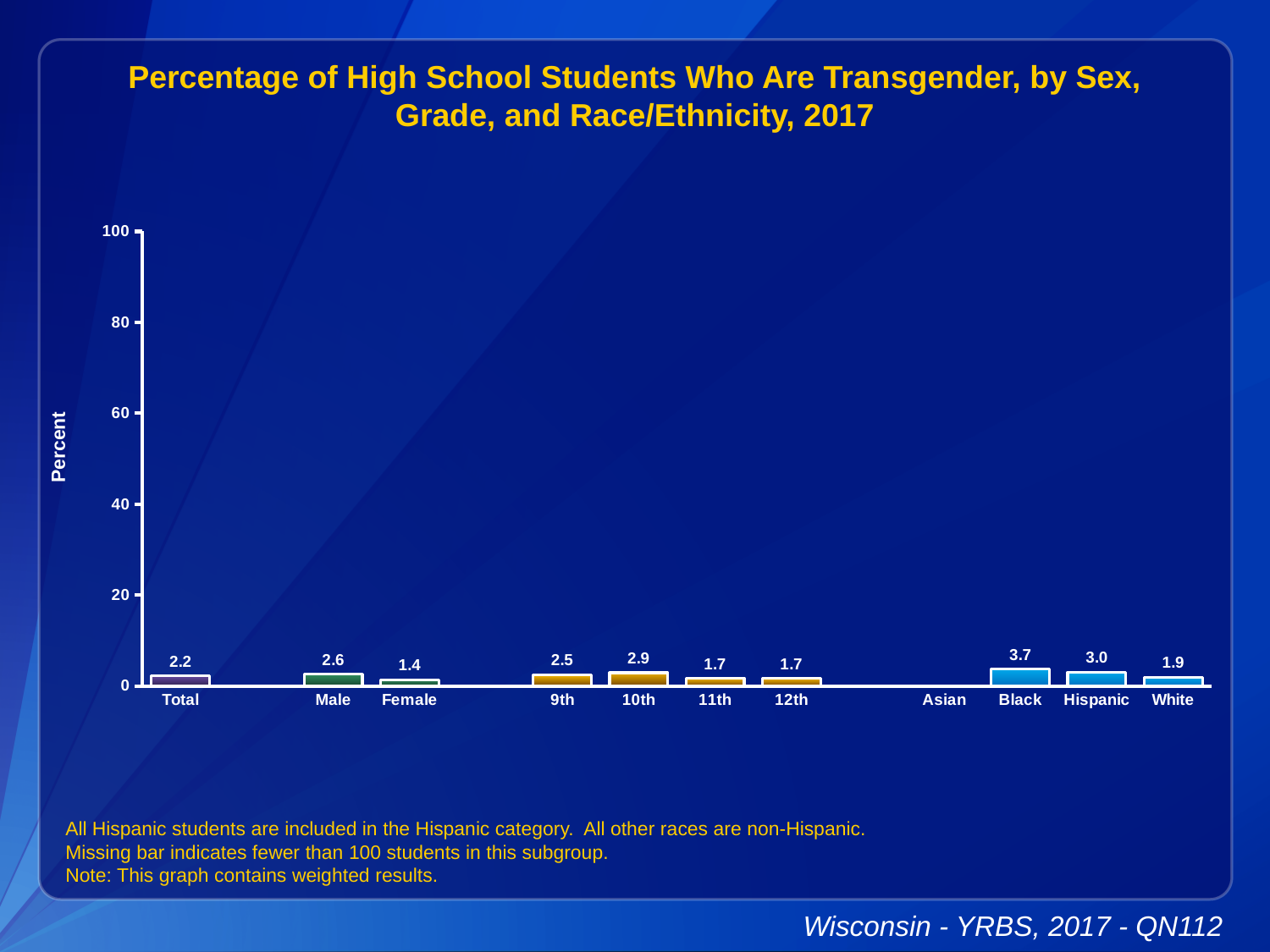
What is the value shown for Black students? 3.7 What is the value shown for 10th grade students? 2.9 Which category has the lowest value among the bars shown? Female Which category on the x axis has no bar displayed? Asian What kind of chart is shown on the slide? bar chart What is the label on the y axis of the chart? Percent Which is larger, the value for Hispanic students or the value for White students? Hispanic What is the difference between the values for Male and Female students? 1.2 Is the value for 9th grade students greater or less than 20? less What is the percentage of high school students who are transgender for the Total category? 2.2 Which category has the highest value on the chart? Black What is the value shown for Female students? 1.4